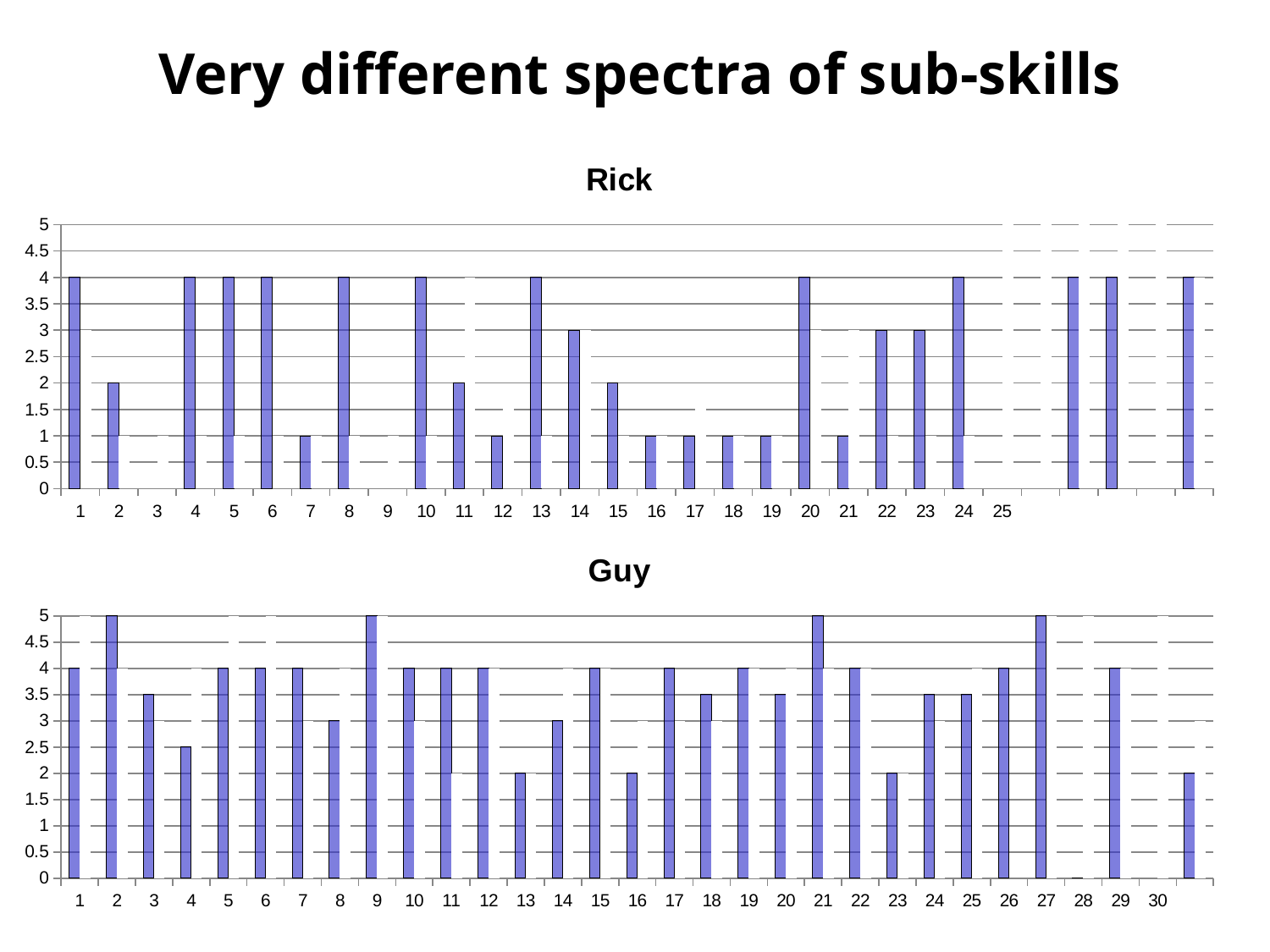
What kind of chart is the Rick chart? bar chart How many categories are labelled on the x axis of the Guy chart? 30 In the Rick chart, what is the value for category 2? 2 In the Rick chart, what is the highest value reached by any bar? 4 In the Guy chart, is the value for category 21 greater or less than 4? greater In the Guy chart, what is the value for category 9? 5 In the Rick chart, what is the value for category 14? 3 In the Rick chart, which is larger, the value for category 22 or the value for category 21? category 22 In the Guy chart, what is the value for category 18? 3.5 In the Guy chart, what is the difference between the values for category 2 and category 13? 3 In the Guy chart, what is the value for category 4? 2.5